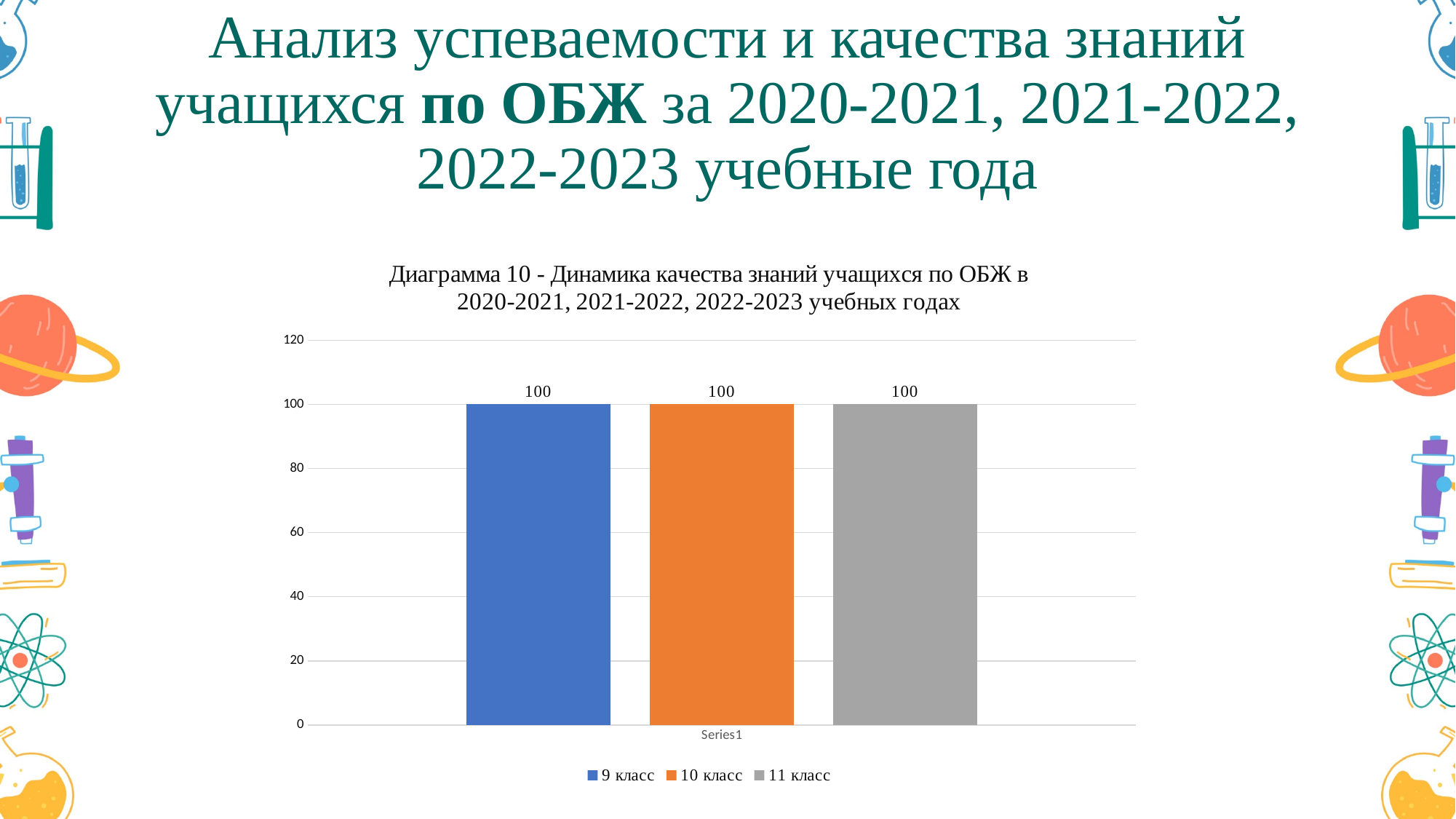
What is the value for 9 класс? 100 What is the highest value shown on the vertical axis? 120 What kind of chart is shown on the slide? bar chart How many series does the legend list? 3 Which colour represents 10 класс in the legend? orange Is the value for 11 класс greater or less than 120? less Is the value for 10 класс greater or less than 80? greater What is the value for 10 класс? 100 What is the difference between the values for 9 класс and 11 класс? 0 How many bars are plotted on the chart? 3 What is the value for 11 класс? 100